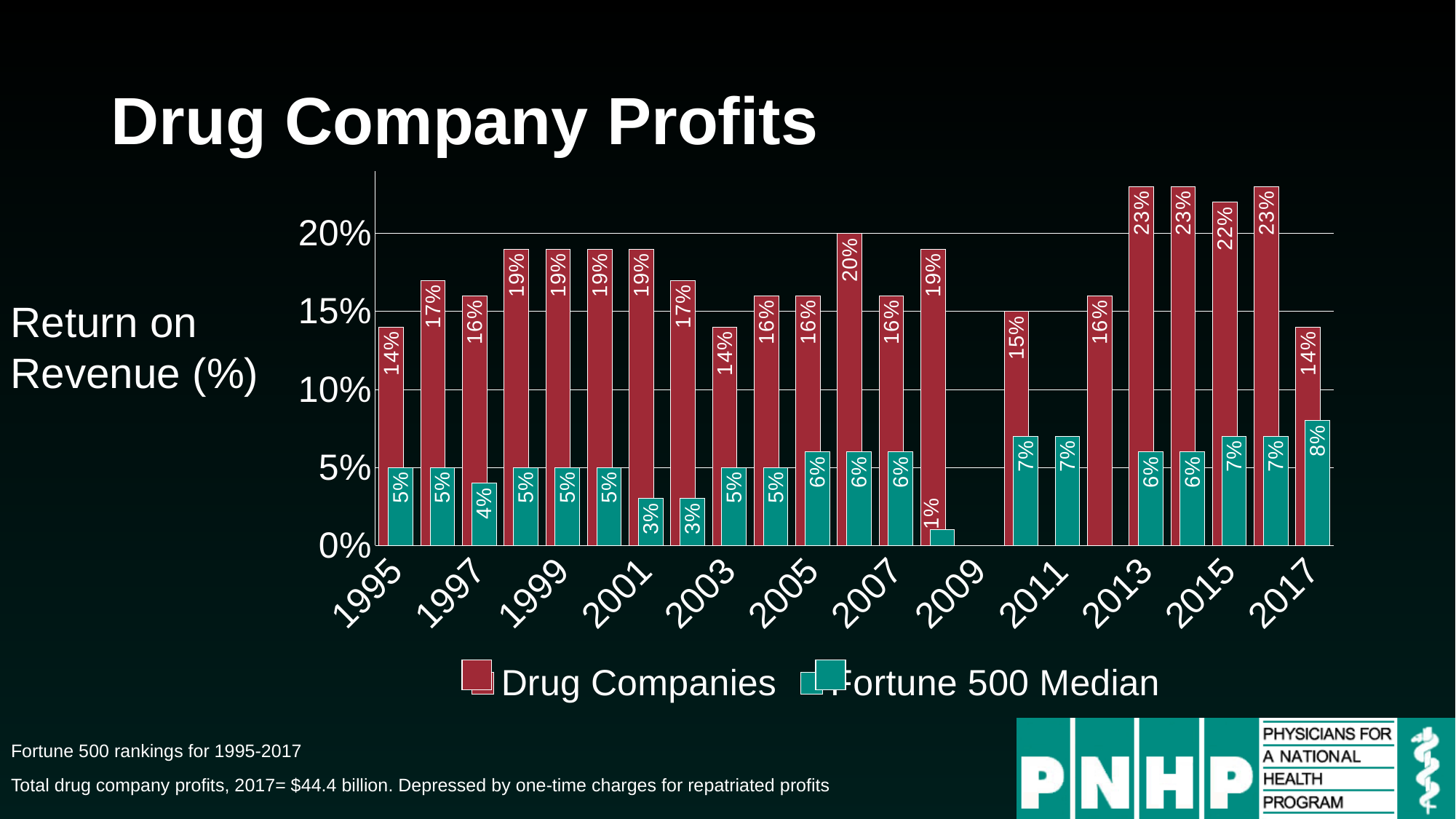
What is the highest Drug Companies value shown on the chart? 23% Is the Drug Companies value for 1995 greater or less than 10%? greater What is the Fortune 500 Median return on revenue for 1997? 4% What is the lowest Fortune 500 Median value shown on the chart? 1% How many series does the legend list? 2 What kind of chart is shown on the slide? bar chart What is the difference between the Drug Companies and Fortune 500 Median values for 2017? 6 percentage points What is the Drug Companies return on revenue for 1995? 14% What is the Fortune 500 Median return on revenue for 2017? 8% Which is larger in 2003, the Drug Companies value or the Fortune 500 Median value? Drug Companies What is the title of the chart? Drug Company Profits What are the two series named in the legend? Drug Companies and Fortune 500 Median